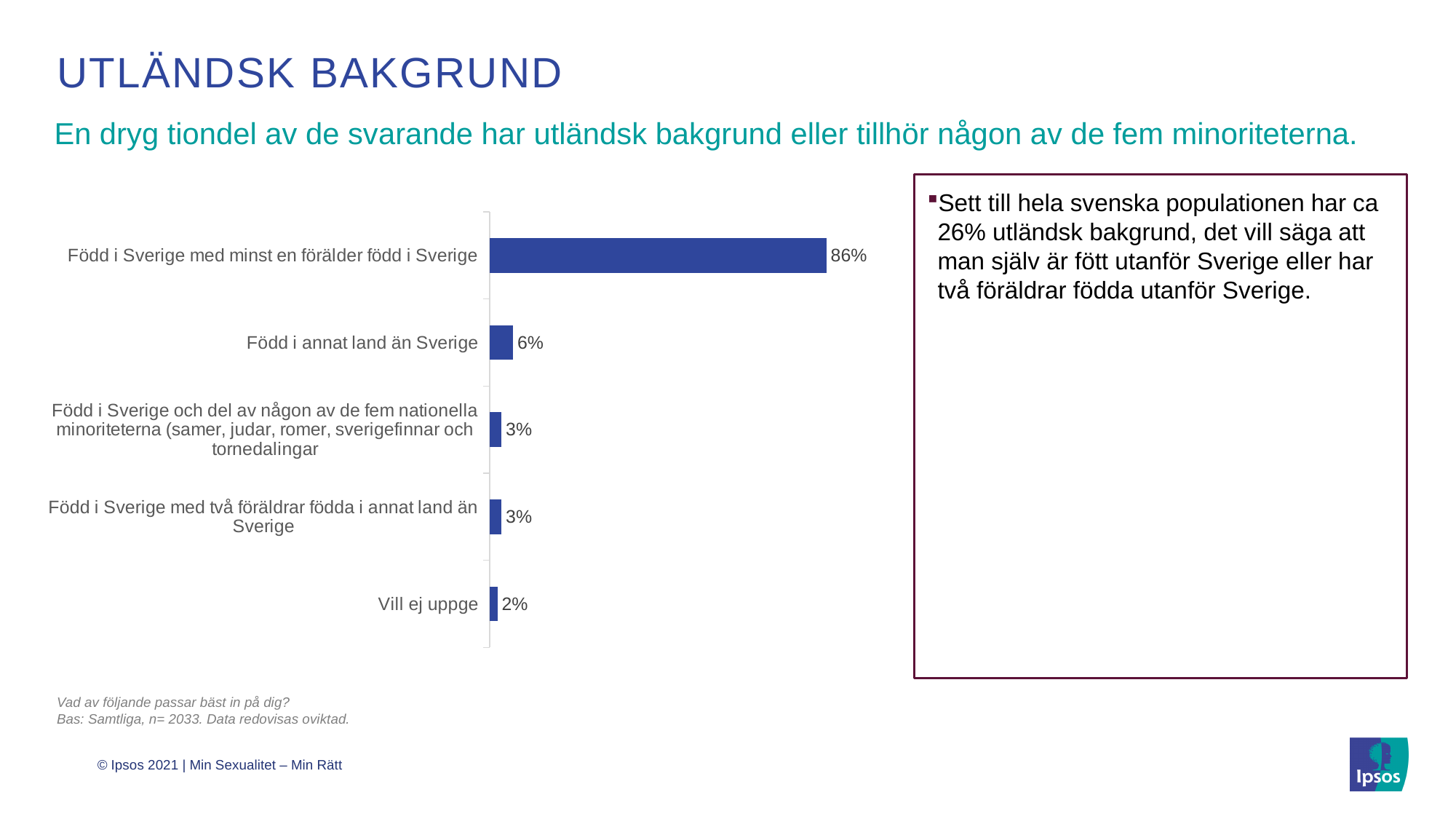
How many categories are shown in the chart? 5 What is the difference between the values for "Född i Sverige med minst en förälder född i Sverige" and "Född i annat land än Sverige"? 80% What is the value for "Vill ej uppge"? 2% What is the difference between the values for "Född i annat land än Sverige" and "Vill ej uppge"? 4% What is the value for "Född i annat land än Sverige"? 6% What kind of chart is shown on the slide? Bar chart Which category has the highest value? Född i Sverige med minst en förälder född i Sverige What is the title of the slide? UTLÄNDSK BAKGRUND Which category has the lowest value? Vill ej uppge What is the value for "Född i Sverige med minst en förälder född i Sverige"? 86% Which is larger: the value for "Född i annat land än Sverige" or the value for "Vill ej uppge"? Född i annat land än Sverige What is the value for "Född i Sverige med två föräldrar födda i annat land än Sverige"? 3%